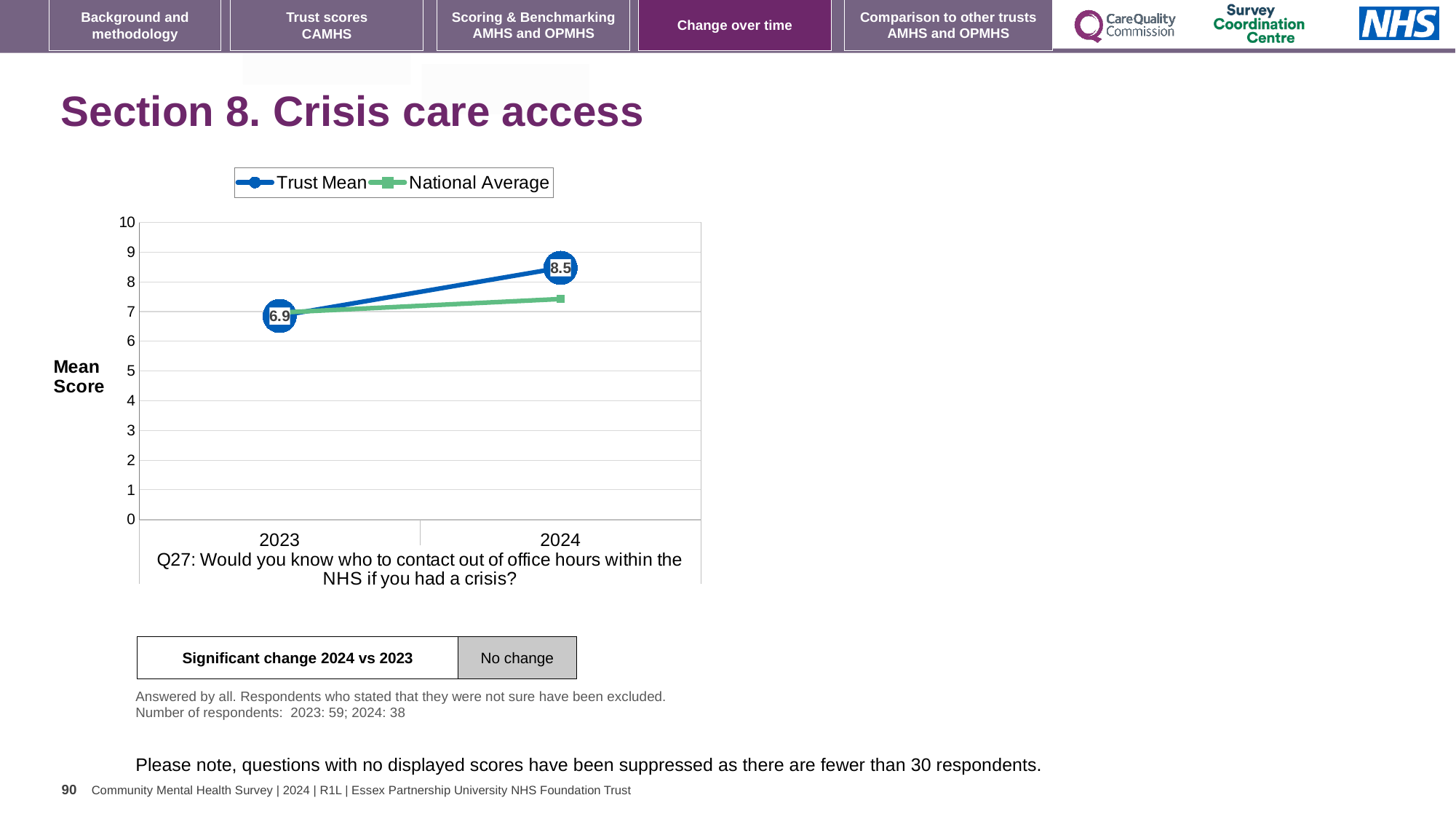
What is the label of the y axis? Mean Score What are the two series named in the legend? Trust Mean and National Average What is the Trust Mean score for 2024? 8.5 How many series does the legend list? 2 Is the National Average value for 2024 greater or less than 8? less How many years are plotted on the x axis? 2 In which year is the Trust Mean score higher, 2023 or 2024? 2024 What is the Trust Mean score for 2023? 6.9 By how much did the Trust Mean score change from 2023 to 2024? 1.6 Does the Trust Mean line rise or fall from 2023 to 2024? rise What kind of chart is shown on the slide? line chart In 2024, which series has the higher value, Trust Mean or National Average? Trust Mean